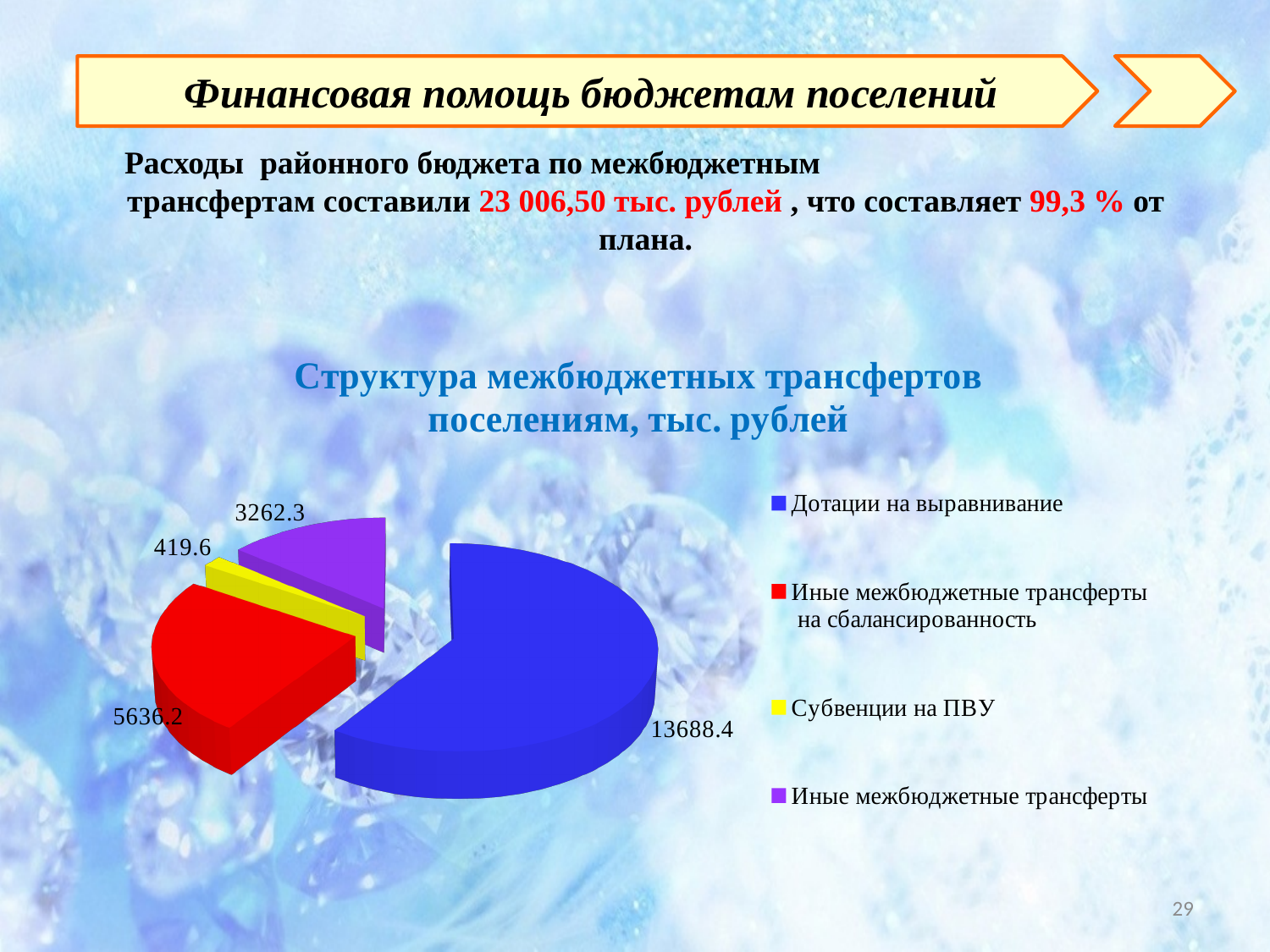
What colour is the slice for Иные межбюджетные трансферты? Purple How many entries does the chart legend list? 4 What is the value for Иные межбюджетные трансферты на сбалансированность? 5636.2 Which is larger: Иные межбюджетные трансферты на сбалансированность or Иные межбюджетные трансферты? Иные межбюджетные трансферты на сбалансированность What is the title of the chart? Структура межбюджетных трансфертов поселениям, тыс. рублей How many slices does the pie chart have? 4 What is the difference between the values for Дотации на выравнивание and Иные межбюджетные трансферты на сбалансированность? 8052.2 What is the value for Дотации на выравнивание? 13688.4 Which category has the largest slice of the pie? Дотации на выравнивание What kind of chart is shown on the slide? Pie chart What is the value for Субвенции на ПВУ? 419.6 Which category has the smallest slice of the pie? Субвенции на ПВУ